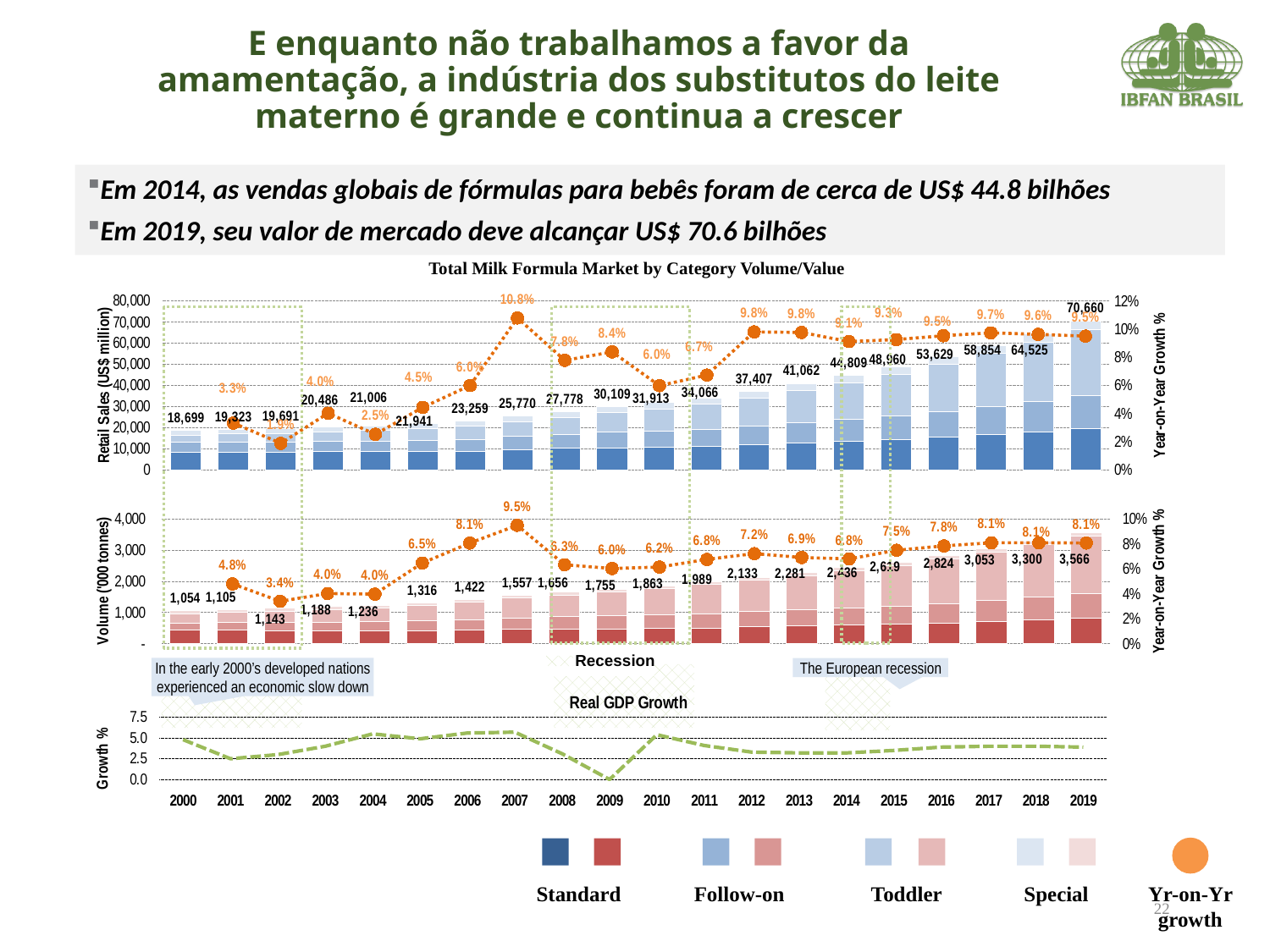
In the Retail Sales chart, which is larger: the total retail sales for 2013 or for 2012? 2013 In the Retail Sales chart, which year has the highest year-on-year growth percentage? 2007 In the Volume ('000 tonnes) chart, what is the total volume labelled for 2019? 3,566 In the Retail Sales chart, what is the year-on-year growth percentage shown for 2007? 10.8% Do the total retail sales values rise or fall from 2000 to 2019 in the Retail Sales chart? rise In the Retail Sales chart, which year has the lowest year-on-year growth percentage? 2002 What kind of chart is used to show Real GDP Growth at the bottom of the slide? line chart How many product categories does the legend list for the stacked bars? 4 In the Volume ('000 tonnes) chart, what is the difference between the total volume for 2019 and the total volume for 2000? 2,512 In the Volume chart, what is the year-on-year growth percentage shown for 2007? 9.5% In the Retail Sales (US$ million) chart, what is the total retail sales value labelled for 2000? 18,699 In the Retail Sales (US$ million) chart, what is the total retail sales value labelled for 2019? 70,660